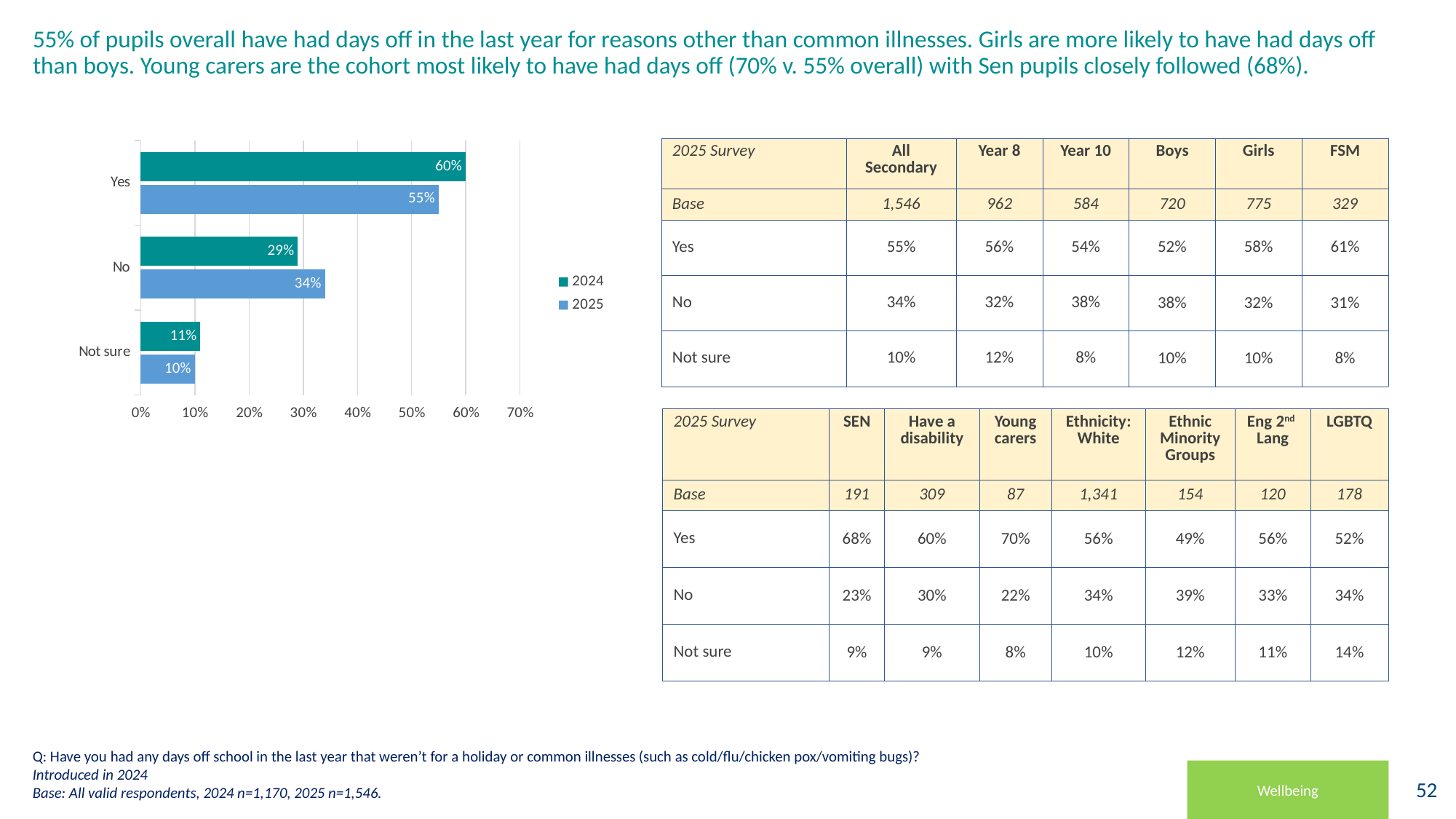
How many categories are shown on the chart? 3 What is the 2025 value for Not sure? 10% What is the 2025 value for No? 34% Which category has the highest 2025 value? Yes What is the difference between the 2024 and 2025 values for No? 5% Which category has the lowest 2024 value? Not sure What kind of chart is shown on the slide? Bar chart How many series does the legend list? 2 What is the difference between the 2024 and 2025 values for Yes? 5% Which is larger for No: the 2024 value or the 2025 value? 2025 What is the 2024 value for Yes? 60% What are the two series listed in the chart legend? 2024 and 2025